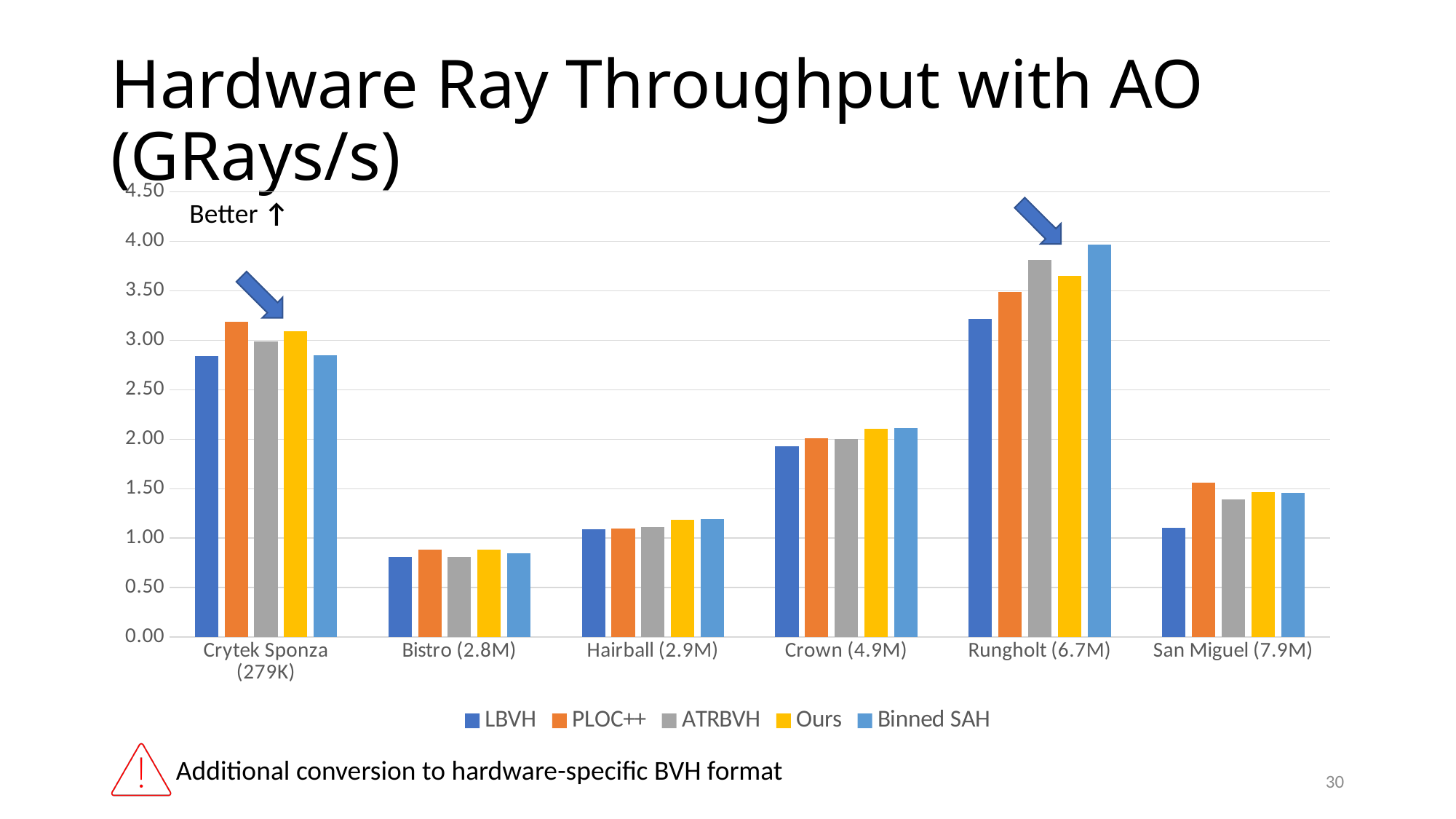
For San Miguel (7.9M), which series has the lowest value? LBVH How many series does the legend list? 5 For Runholt (6.7M), which series has the highest value? Binned SAH What is the title of the chart on the slide? Hardware Ray Throughput with AO (GRays/s) For Runholt (6.7M), which is larger: LBVH or PLOC++? PLOC++ Is the value for LBVH on Runholt (6.7M) greater or less than 3.00? greater Which scene has the lowest ray throughput bars overall? Bistro (2.8M) What kind of chart is shown on the slide? bar chart Is the value for LBVH on Bistro (2.8M) greater or less than 1.00? less How many scene categories are shown on the x axis? 6 Which scene has the highest ray throughput bars overall? Rungholt (6.7M) Is the value for ATRBVH on Runholt (6.7M) greater or less than 3.50? greater